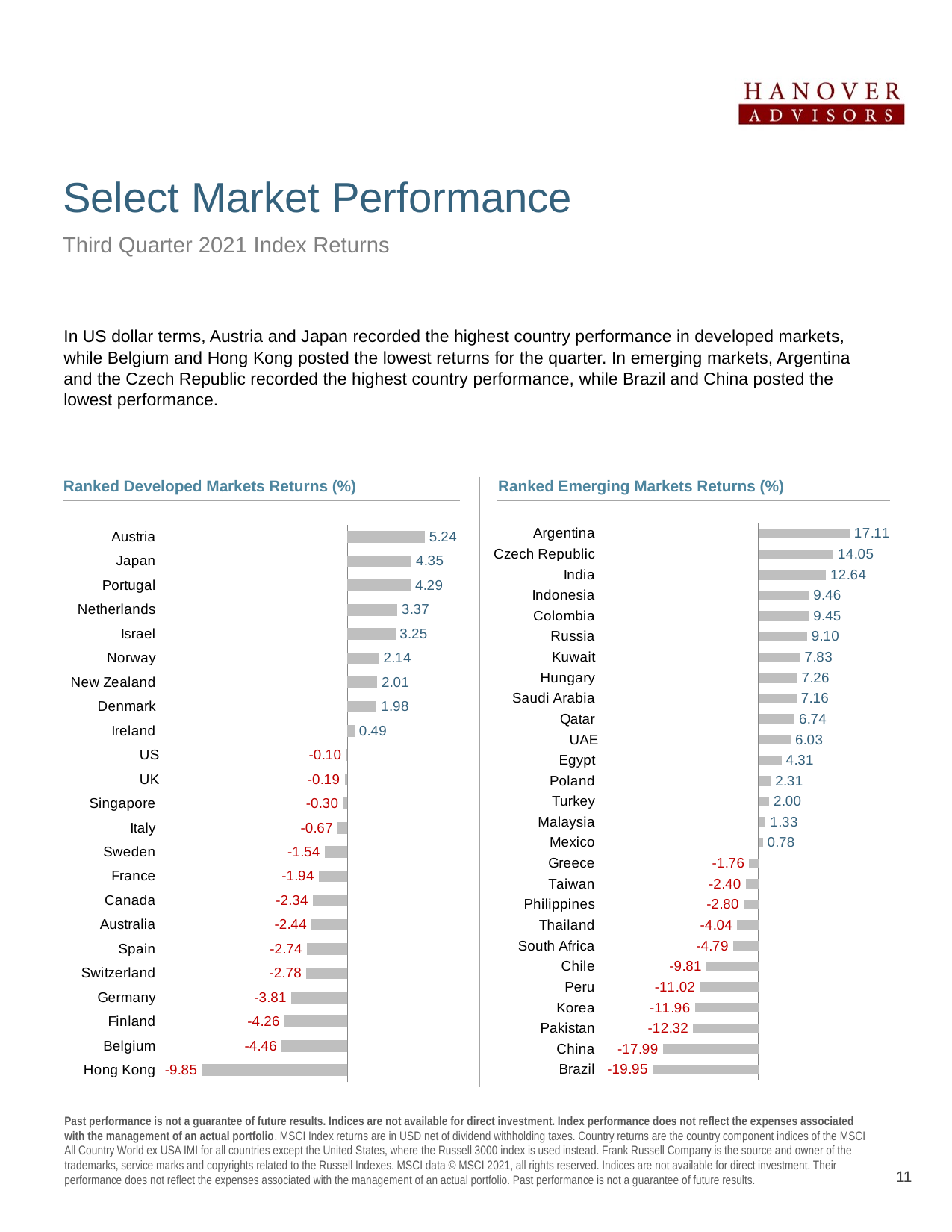
In the Ranked Developed Markets Returns (%) chart, which is larger, the value for Norway or the value for Denmark? Norway What kind of chart is the Ranked Emerging Markets Returns (%) chart? Bar chart How many countries are shown in the Ranked Developed Markets Returns (%) chart? 23 In the Ranked Developed Markets Returns (%) chart, what is the difference between the values for Austria and Japan? 0.89 In the Ranked Emerging Markets Returns (%) chart, which country has the lowest return? Brazil How many countries are shown in the Ranked Emerging Markets Returns (%) chart? 27 In the Ranked Emerging Markets Returns (%) chart, which is larger, the value for Egypt or the value for Poland? Egypt In the Ranked Emerging Markets Returns (%) chart, what is the difference between the values for Argentina and Czech Republic? 3.06 In the Ranked Developed Markets Returns (%) chart, what is the value for Hong Kong? -9.85 In the Ranked Developed Markets Returns (%) chart, which country has the highest return? Austria In the Ranked Emerging Markets Returns (%) chart, what is the value for Russia? 9.10 In the Ranked Developed Markets Returns (%) chart, what is the value for Portugal? 4.29